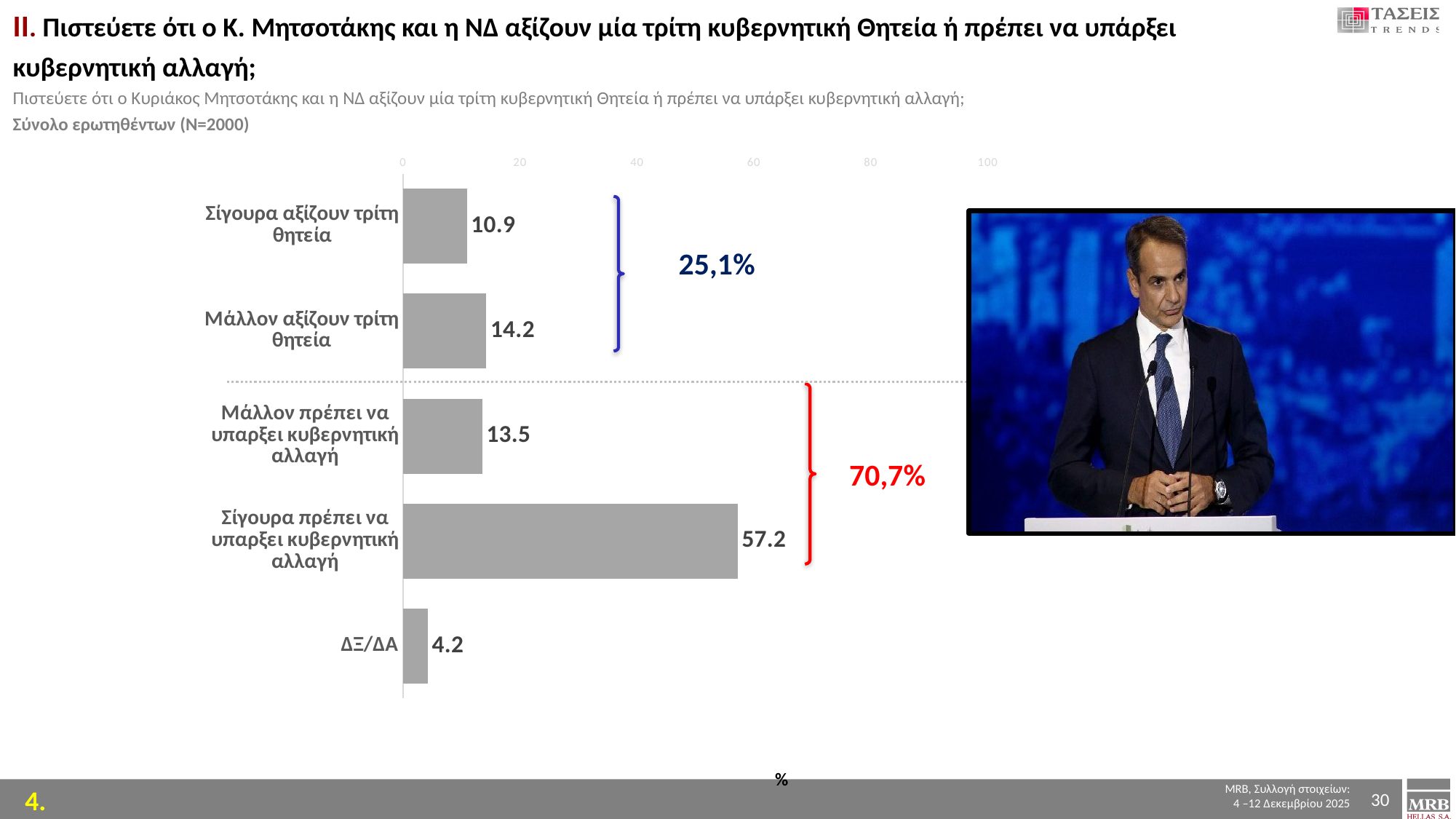
What is the difference between the values for "Σίγουρα πρέπει να υπάρξει κυβερνητική αλλαγή" and "Μάλλον πρέπει να υπάρξει κυβερνητική αλλαγή"? 43.7 What value is shown for "Μάλλον αξίζουν τρίτη θητεία"? 14.2 How many categories are shown in the bar chart? 5 What value is shown for "Μάλλον πρέπει να υπάρξει κυβερνητική αλλαγή"? 13.5 Which category has the lowest value? ΔΞ/ΔΑ What kind of chart is shown on the slide? Bar chart What value is shown for "Σίγουρα αξίζουν τρίτη θητεία"? 10.9 What value is shown for "ΔΞ/ΔΑ"? 4.2 What value is shown for "Σίγουρα πρέπει να υπάρξει κυβερνητική αλλαγή"? 57.2 What combined percentage is shown by the red bracket next to the two "κυβερνητική αλλαγή" bars? 70,7% Which is larger: the value for "Μάλλον αξίζουν τρίτη θητεία" or for "Σίγουρα αξίζουν τρίτη θητεία"? Μάλλον αξίζουν τρίτη θητεία Which category has the highest value? Σίγουρα πρέπει να υπάρξει κυβερνητική αλλαγή